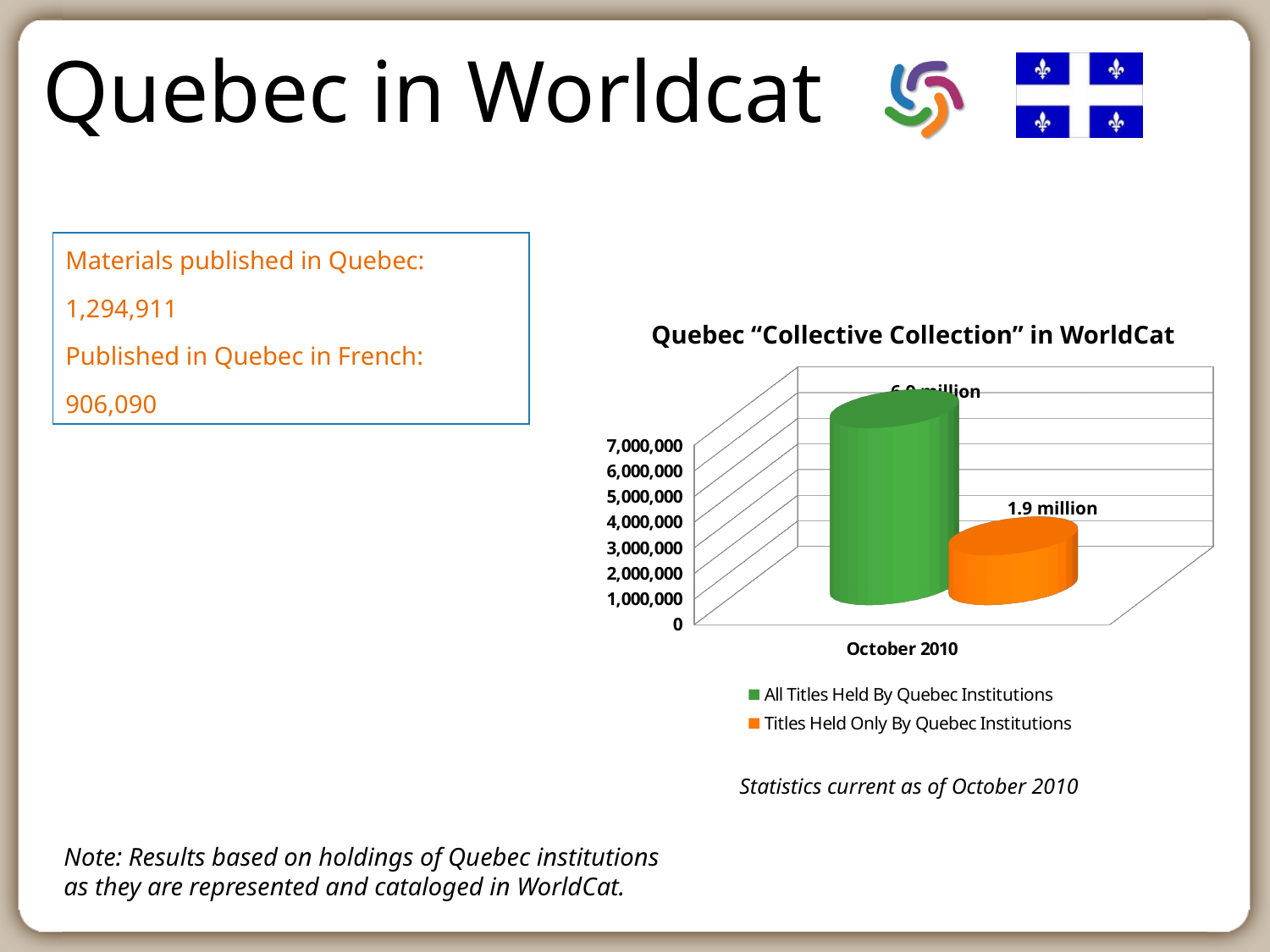
What is the value for Titles Held Only By Quebec Institutions? 1.9 million What colour is the bar for Titles Held Only By Quebec Institutions? orange How many categories are shown on the x axis of the chart? 1 What category label appears on the x axis of the chart? October 2010 Is the value for Titles Held Only By Quebec Institutions greater or less than 3,000,000? less What is the title of the chart? Quebec "Collective Collection" in WorldCat How many series does the chart legend list? 2 Is the value for All Titles Held By Quebec Institutions greater or less than 5,000,000? greater Which series has the higher value: All Titles Held By Quebec Institutions or Titles Held Only By Quebec Institutions? All Titles Held By Quebec Institutions What kind of chart is shown on the slide? bar chart Which series has the highest value in the chart? All Titles Held By Quebec Institutions Which series has the lowest value in the chart? Titles Held Only By Quebec Institutions